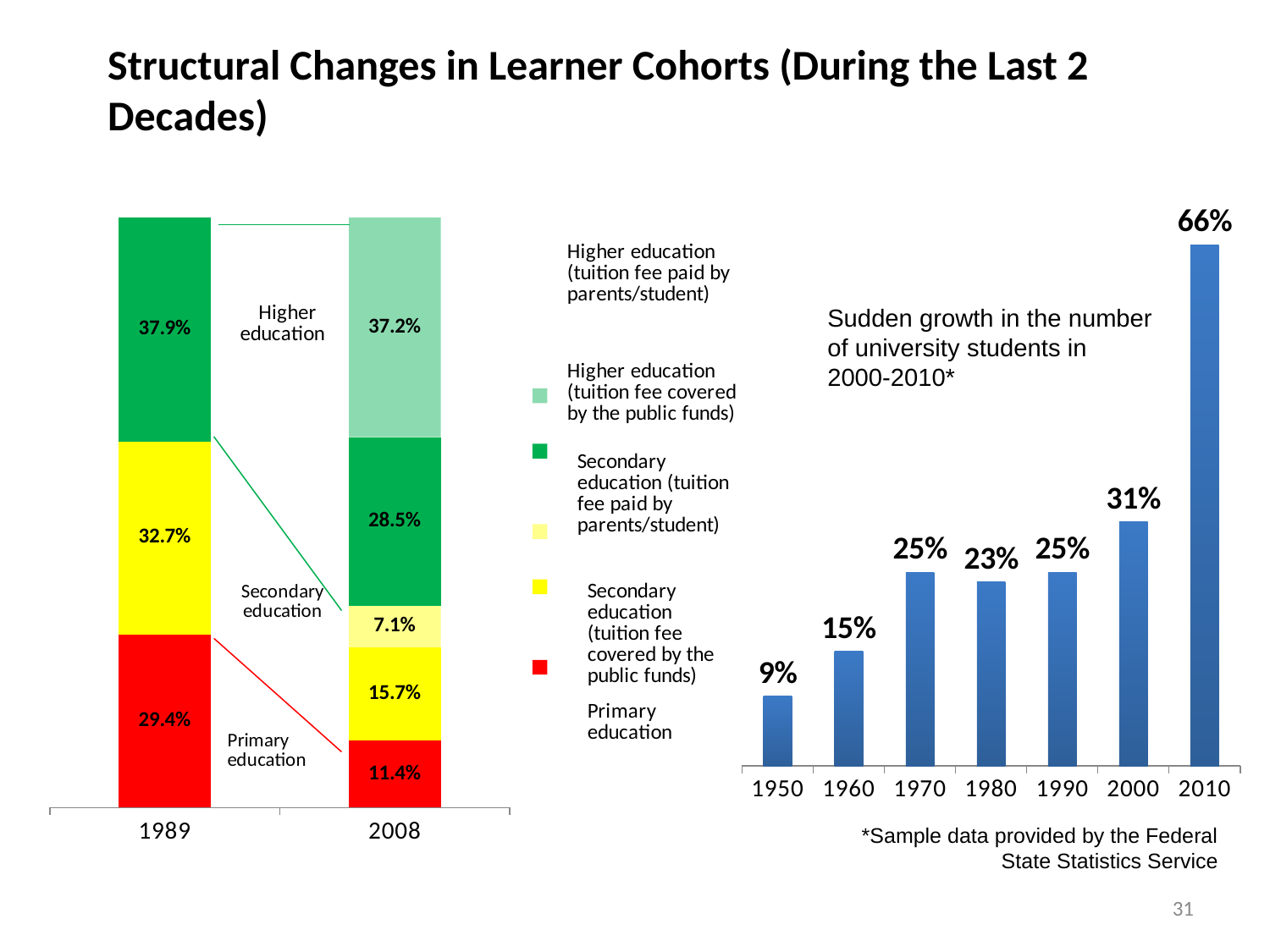
In the right-hand bar chart, what is the value for 2010? 66% What type of chart is the right-hand chart? Bar chart In the left-hand stacked bar chart, what is the difference between the Primary education values for 1989 and 2008? 18.0% In the right-hand bar chart, which is larger, the value for 1980 or the value for 2000? 2000 How many years are shown on the x axis of the right-hand bar chart? 7 In the left-hand stacked bar chart, what is the value of the red Primary education segment for 2008? 11.4% In the left-hand stacked bar chart, what is the value of the red Primary education segment for 1989? 29.4% In the right-hand bar chart, which year has the lowest value? 1950 In the right-hand bar chart, what is the difference between the values for 2010 and 2000? 35% In the right-hand bar chart, what is the value for 1950? 9% In the left-hand stacked bar chart, what is the value of the topmost (light green) segment for 2008? 37.2% In the right-hand bar chart, which year has the highest value? 2010